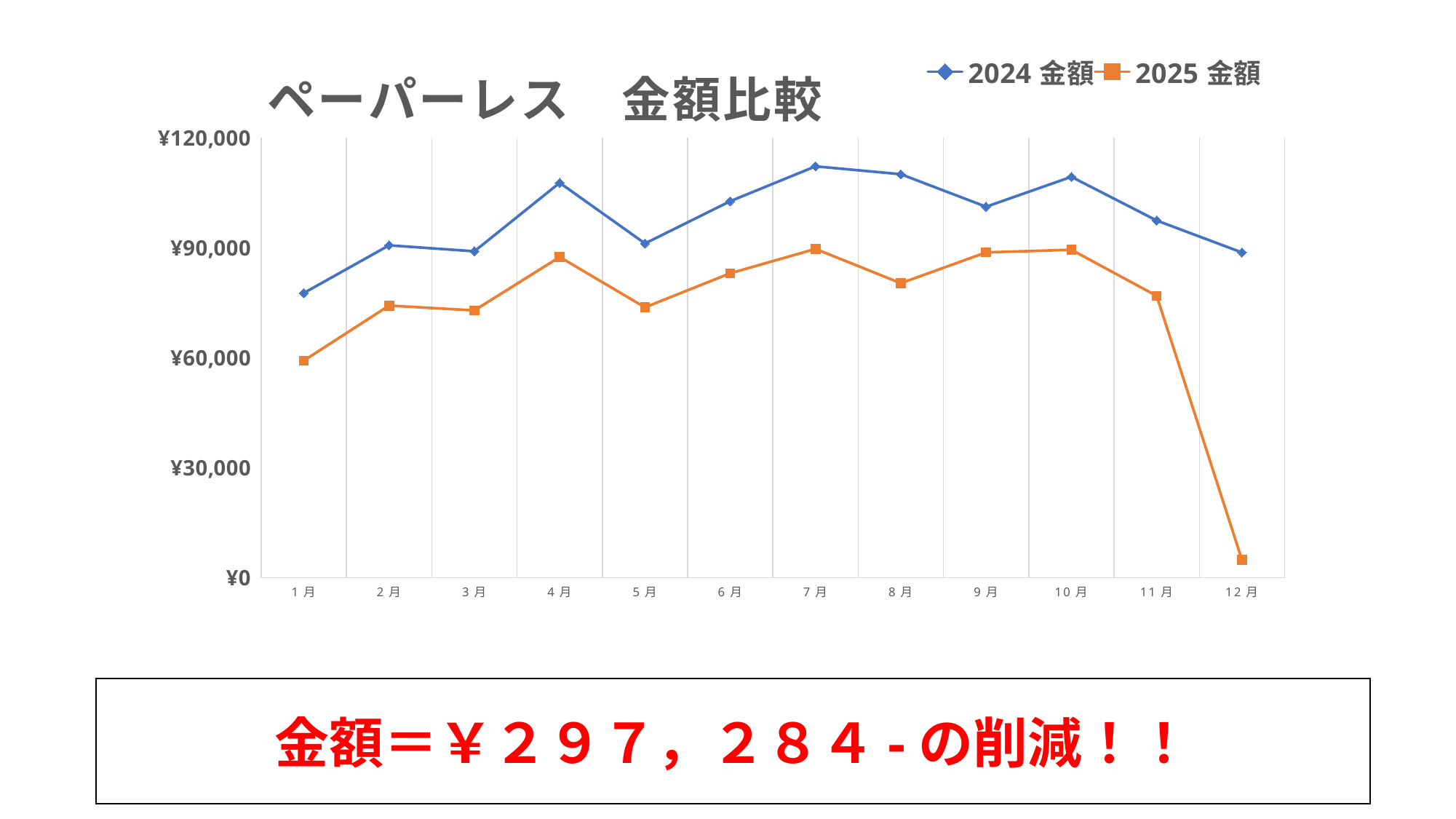
What is the title of the chart? ペーパーレス 金額比較 What kind of chart is shown on the slide? line chart Is the 2025 金額 value for 12月 greater or less than ¥30,000? less Is the 2024 金額 value for 7月 greater or less than ¥90,000? greater Does the 2025 金額 series rise or fall from 10月 to 12月? fall Which month has the lowest value for the 2024 金額 series? 1月 How many months are plotted along the x axis? 12 Which month has the lowest value for the 2025 金額 series? 12月 Is the 2024 金額 value for 1月 greater or less than ¥90,000? less In 1月, which series has the larger value, 2024 金額 or 2025 金額? 2024 金額 How many series does the legend list? 2